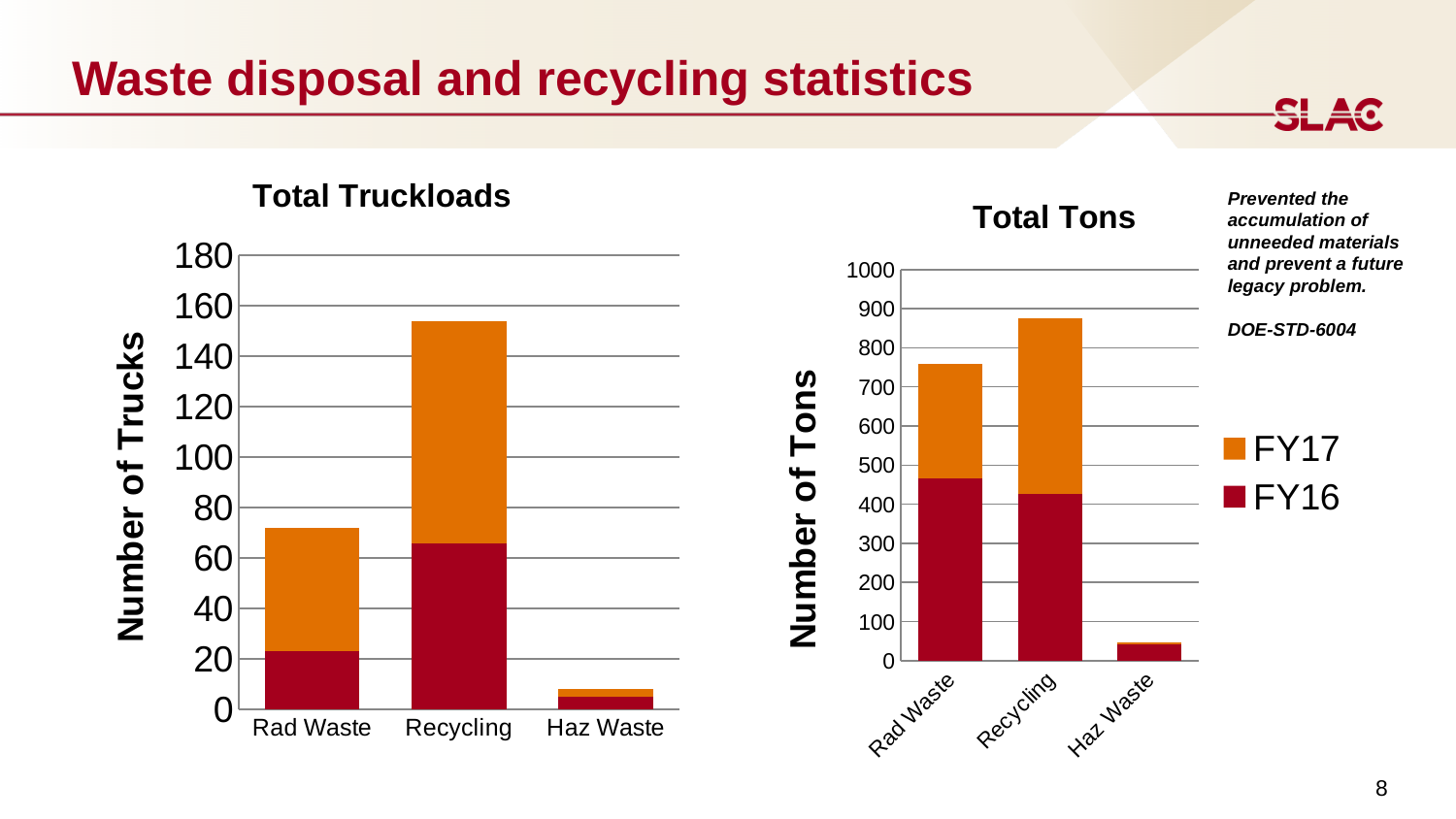
In the Total Truckloads chart, is the total value for Rad Waste greater or less than 80? less How many series does the legend next to the Total Tons chart list? 2 In the Total Truckloads chart, which category has the tallest bar? Recycling In the Total Truckloads chart, is the total value for Haz Waste greater or less than 20? less In the Total Tons chart, is the total value for Haz Waste greater or less than 100? less In the Total Tons chart, which category has the shortest bar? Haz Waste In the Total Tons chart, which has the larger total: Rad Waste or Recycling? Recycling In the Total Tons chart, which category has the tallest bar? Recycling In the Total Truckloads chart, which category has the shortest bar? Haz Waste How many categories are shown on the x axis of the Total Tons chart? 3